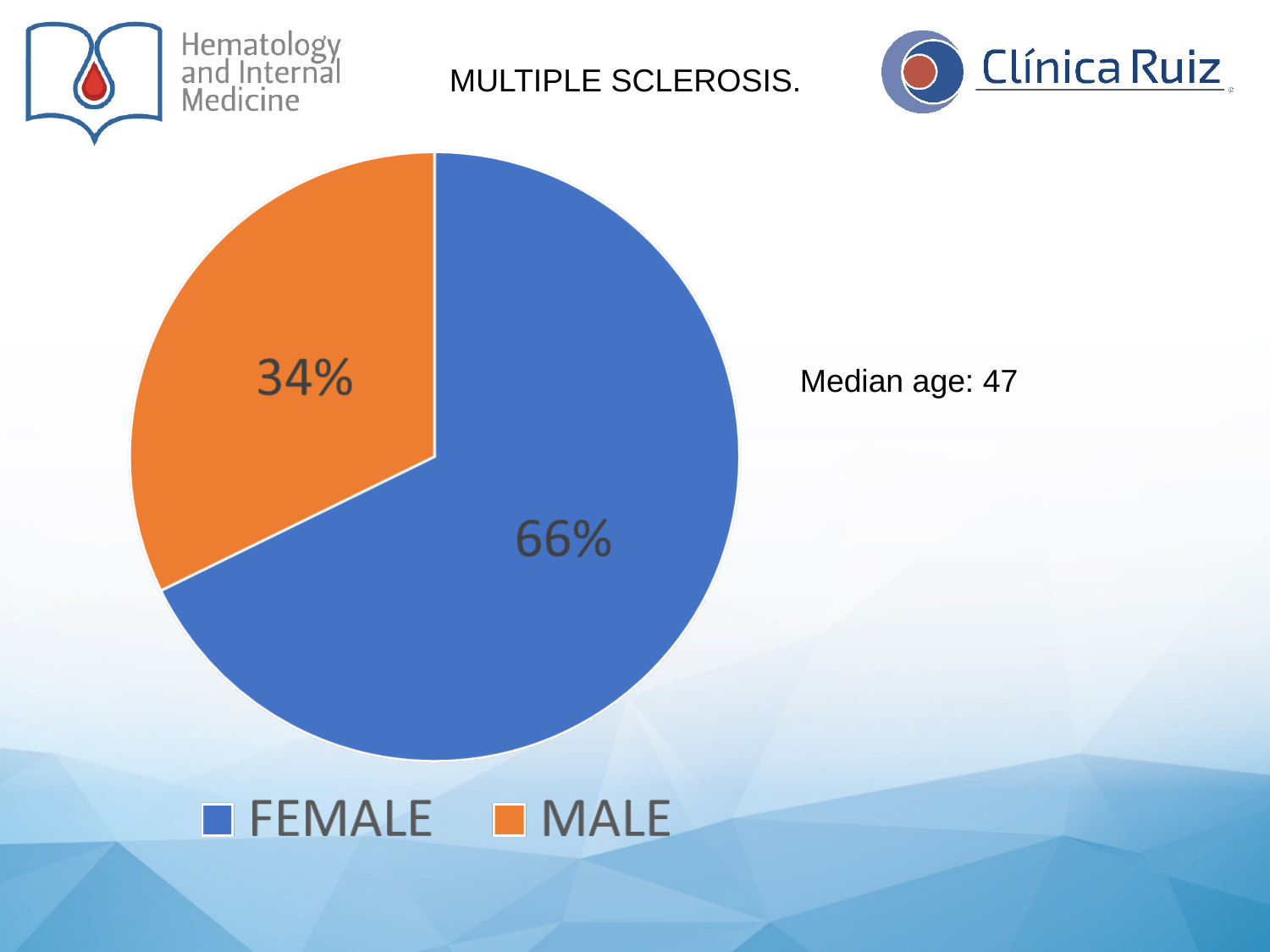
What is the difference in percentage points between the FEMALE and MALE slices? 32 What colour is the FEMALE slice in the pie chart? blue Is the FEMALE share greater or less than 50%? greater Which category has the largest share of the pie chart? FEMALE Which category has the smallest share of the pie chart? MALE What percentage of the pie chart is MALE? 34% What colour is the MALE slice in the pie chart? orange What percentage of the pie chart is FEMALE? 66% How many entries does the legend list? 2 What kind of chart is shown on the slide? pie chart Which slice is larger, FEMALE or MALE? FEMALE How many slices does the pie chart have? 2